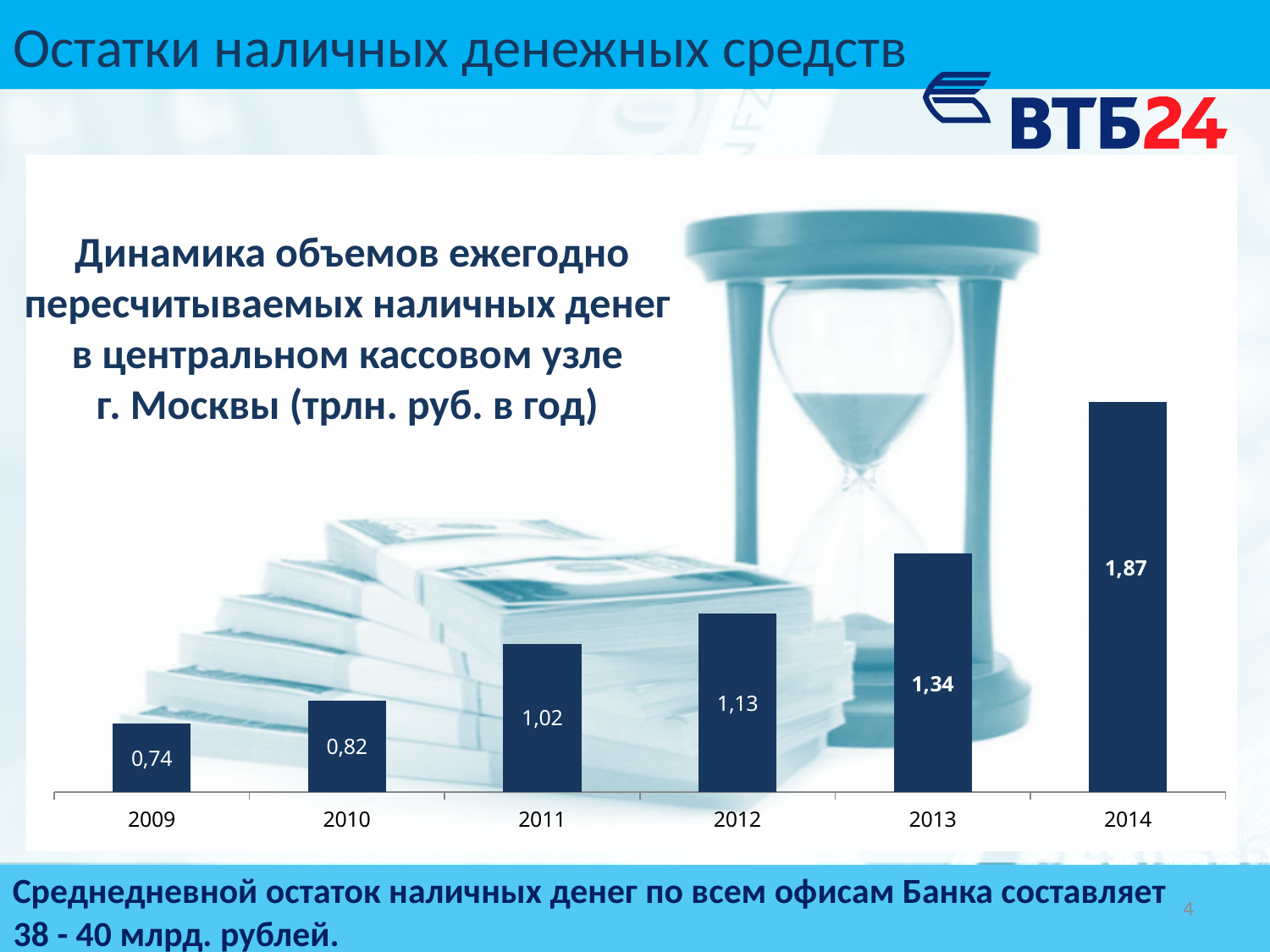
Do the values rise or fall from 2009 to 2014? rise What is the value for 2014? 1,87 Which is larger, the value for 2012 or the value for 2013? 2013 What is the difference between the values for 2014 and 2013? 0,53 What is the difference between the values for 2011 and 2010? 0,20 What is the value for 2012? 1,13 What kind of chart is shown? bar chart Which year has the lowest value? 2009 Which year has the highest value? 2014 What is the value for 2009? 0,74 How many years are shown on the x axis? 6 In what units are the chart values given, according to the chart title? трлн. руб. в год